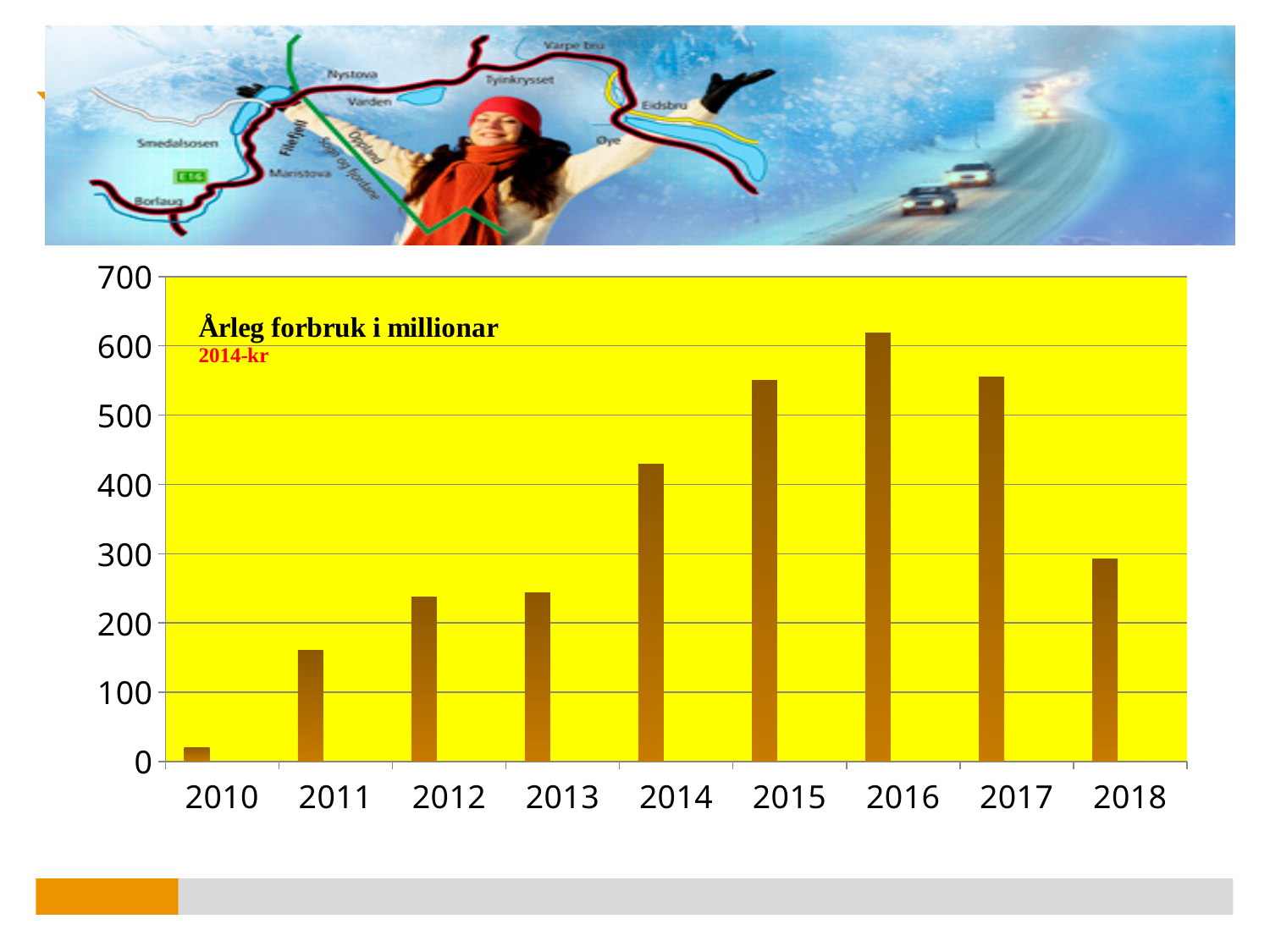
What kind of chart is shown on the slide? bar chart What unit note is printed in red below the chart title? 2014-kr Which year has the highest bar in the chart? 2016 Do the values rise or fall from 2010 to 2016? rise Is the value for 2011 greater or less than 200? less Is the value for 2016 greater or less than 600? greater Is the value for 2014 greater or less than 400? greater What is the title of the chart? Årleg forbruk i millionar How many years are shown on the x axis of the chart? 9 Which year has the lowest bar in the chart? 2010 Which year has the larger value, 2014 or 2018? 2014